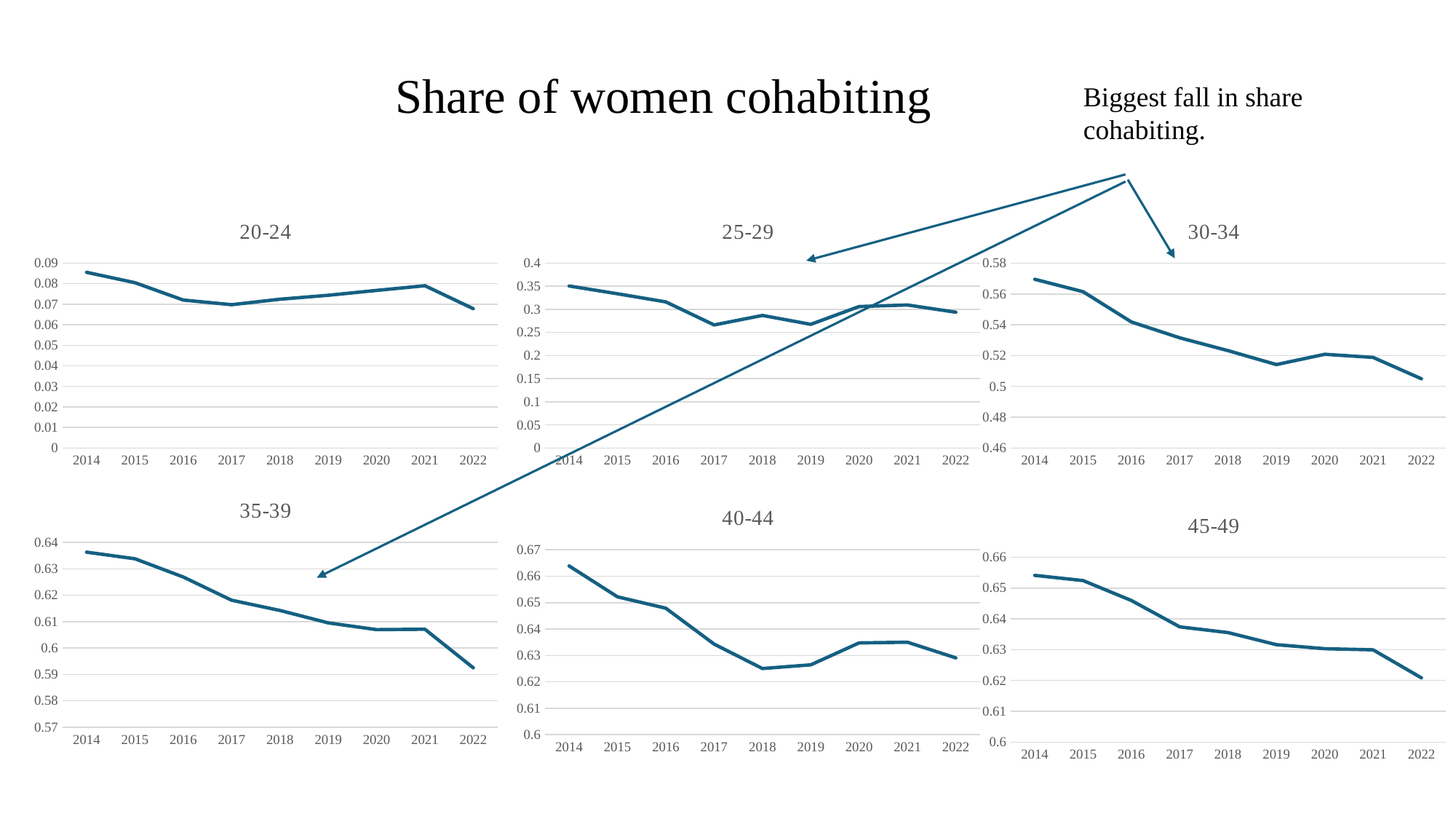
In the "40-44" chart, is the value for 2014 greater or less than 0.66? greater In the "45-49" chart, do the values overall rise or fall from 2014 to 2022? fall In the "25-29" chart, which year has the highest value? 2014 What kind of chart is the "20-24" chart? line chart In the "20-24" chart, which is larger, the value for 2014 or the value for 2017? 2014 In the "30-34" chart, is the value for 2014 greater or less than 0.56? greater How many charts are shown on the slide? 6 In the "30-34" chart, which year has the lowest value? 2022 In the "35-39" chart, is the value for 2022 greater or less than 0.6? less In the "25-29" chart, which year has the lowest value? 2017 How many data points are plotted in the "30-34" chart? 9